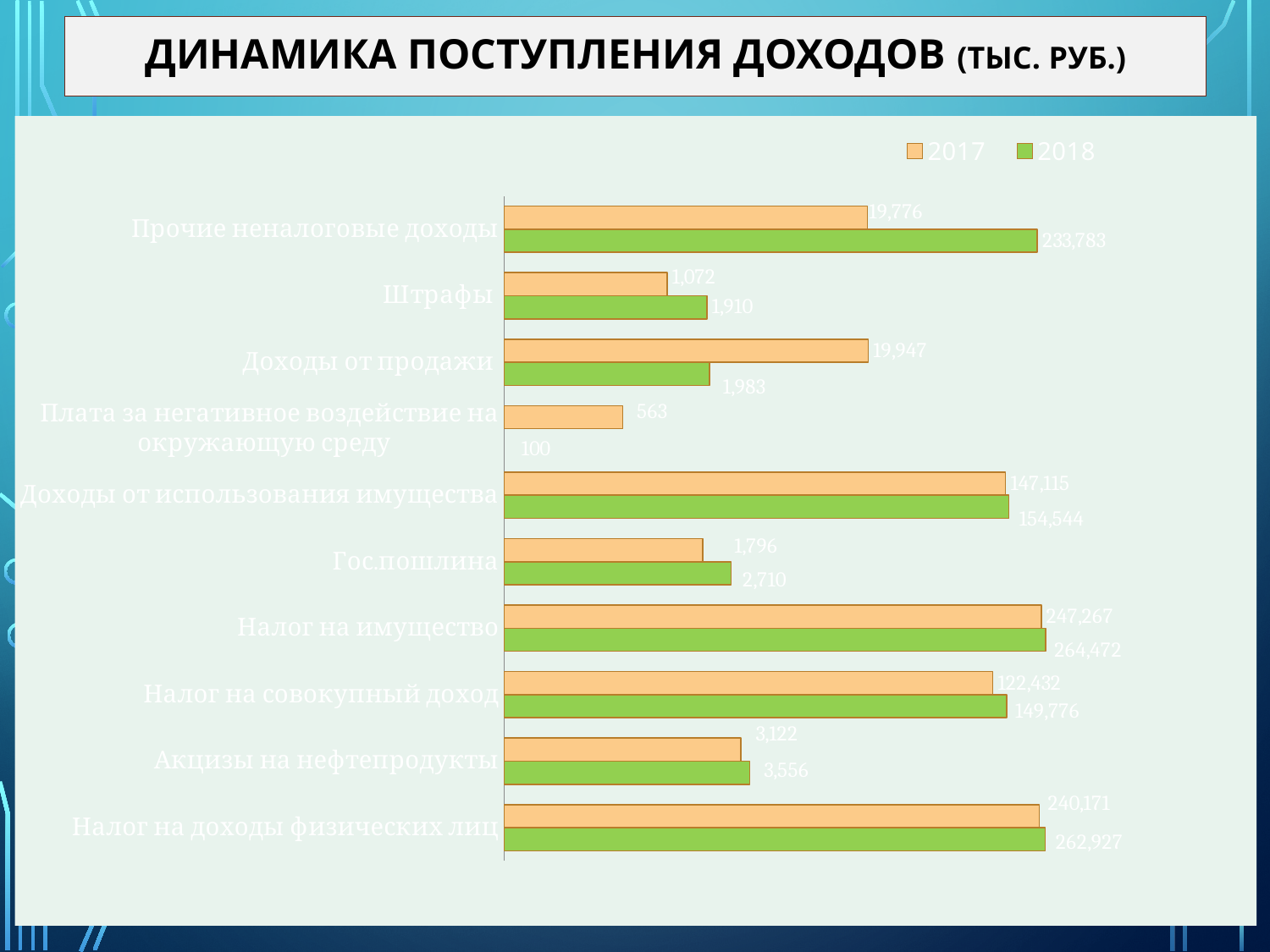
Which colour represents the 2018 series in the legend? green What type of chart is shown on the slide? bar chart What is the 2017 value for Плата за негативное воздействие на окружающую среду? 563 How many series does the legend list? 2 What is the 2018 value for Налог на имущество? 264,472 What is the 2017 value for Налог на доходы физических лиц? 240,171 What is the difference between the 2018 and 2017 values for Налог на доходы физических лиц? 22,756 Which is larger for Доходы от продажи: the 2017 value or the 2018 value? 2017 How many categories are shown on the chart? 10 Which category has the highest 2018 value? Налог на имущество Which category has the lowest 2018 value? Плата за негативное воздействие на окружающую среду What is the 2018 value for Прочие неналоговые доходы? 233,783